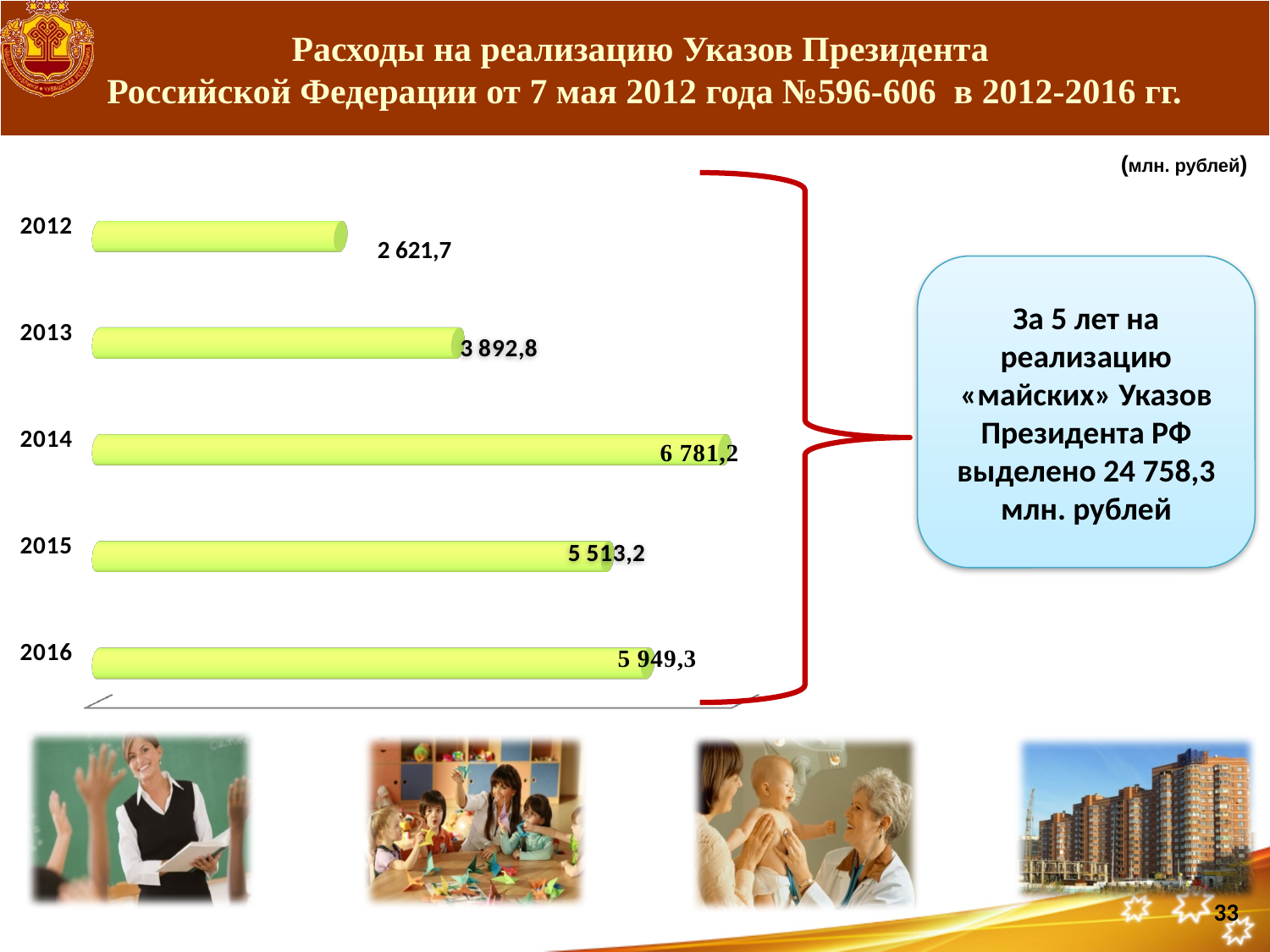
Which year has the lowest value on the chart? 2012 What is the difference between the values for 2014 and 2012? 4 159,5 Which is larger, the value for 2015 or the value for 2016? 2016 What is the difference between the values for 2016 and 2015? 436,1 What is the value for 2014 on the chart? 6 781,2 Which year has the highest value on the chart? 2014 What is the value for 2016 on the chart? 5 949,3 In what units are the chart values given, according to the slide? млн. рублей What is the value for 2012 on the chart? 2 621,7 What kind of chart is shown on the slide? Bar chart Do the values rise or fall from 2012 to 2014? Rise How many years are shown on the chart? 5